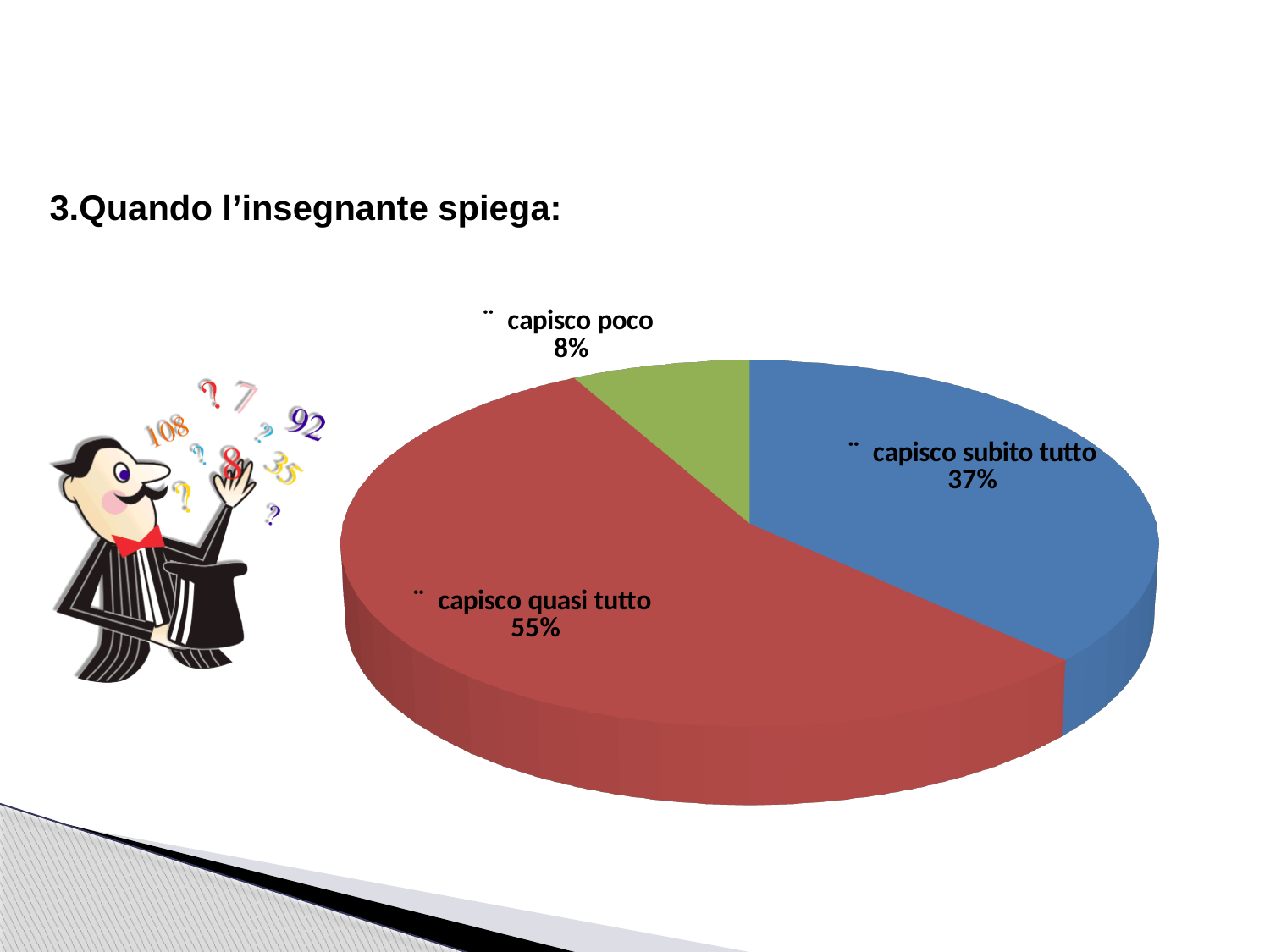
What kind of chart is shown on the slide? pie chart How many slices does the pie chart have? 3 Which is larger: 'capisco subito tutto' or 'capisco poco'? capisco subito tutto Which slice of the pie is the largest? capisco quasi tutto What is the difference in percentage points between 'capisco quasi tutto' and 'capisco subito tutto'? 18 What percentage of the pie is 'capisco quasi tutto'? 55% Which slice of the pie is the smallest? capisco poco What percentage of the pie is 'capisco poco'? 8% What colour is the 'capisco poco' slice? green What is the combined share of 'capisco subito tutto' and 'capisco poco'? 45% What percentage of the pie is 'capisco subito tutto'? 37% What is the title text above the chart? 3.Quando l'insegnante spiega: